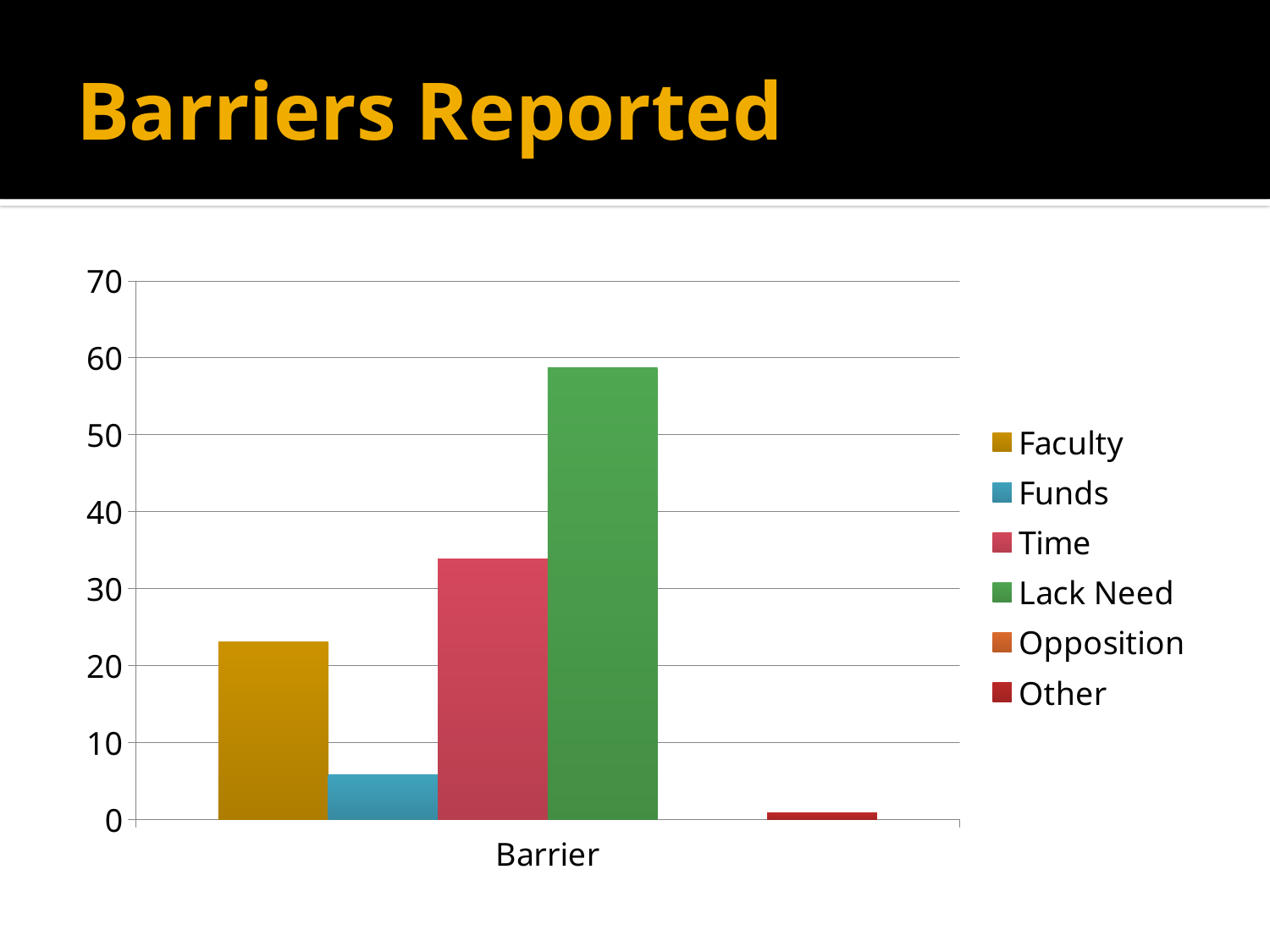
What kind of chart is shown on the slide? bar chart Which is larger, the value for Faculty or the value for Funds? Faculty Which series has no visible bar in the chart? Opposition Which is larger, the value for Time or the value for Faculty? Time Is the value for Other greater or less than 10? less Is the value for Time greater or less than 30? greater Which series has the tallest bar? Lack Need How many series does the legend list? 6 What is the label on the x axis of the chart? Barrier Is the value for Faculty greater or less than 20? greater